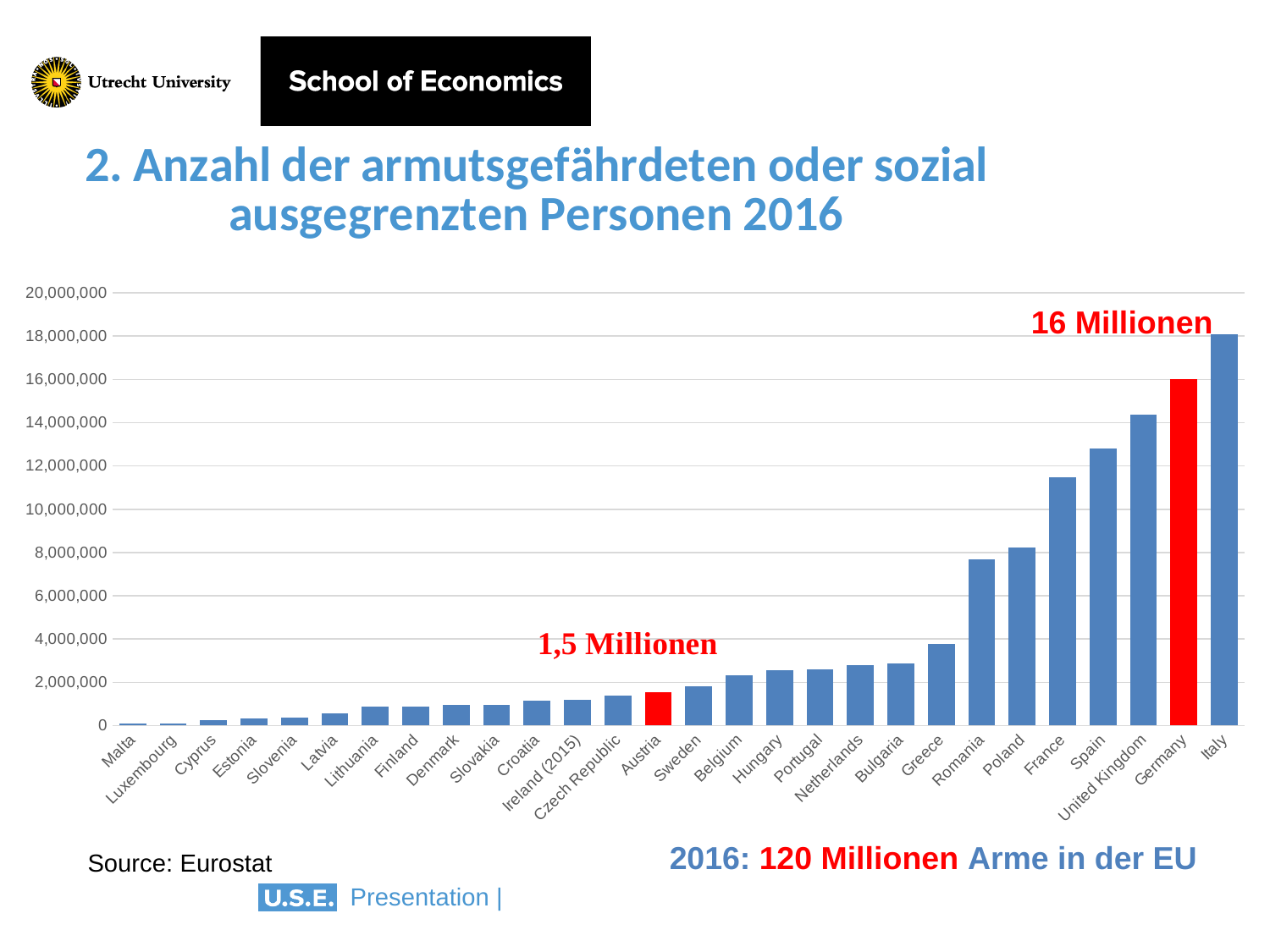
Is the value for Greece greater or less than 4,000,000? less What kind of chart is shown on the slide? bar chart Do the bar values rise or fall from left to right along the x axis? rise Is the value for France greater or less than 10,000,000? greater What value is labelled for Austria in the chart? 1,5 Millionen How many countries are shown on the x axis of the chart? 28 Which has the larger value, Spain or Poland? Spain Which two countries' bars are coloured red in the chart? Austria and Germany Which country has the highest bar in the chart? Italy What value is labelled for Germany in the chart? 16 Millionen Is the value for Romania greater or less than 8,000,000? less